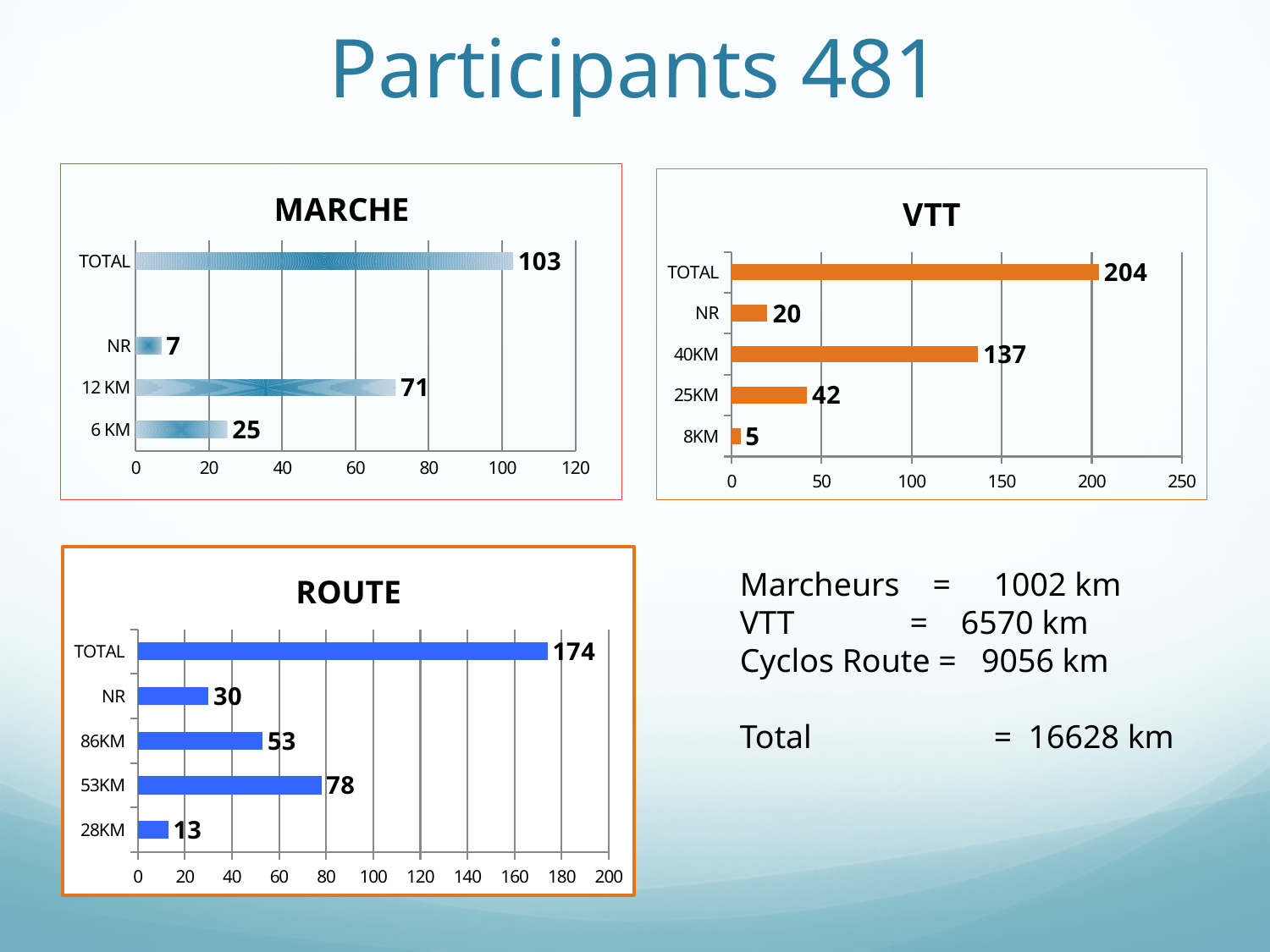
In the ROUTE chart, what is the value for 53KM? 78 In the ROUTE chart, how many categories are shown? 5 In the VTT chart, what is the value for 40KM? 137 What kind of chart is the VTT chart? bar chart What is the title of the chart at the bottom left of the slide? ROUTE In the MARCHE chart, how many categories are shown? 4 In the VTT chart, which category has the lowest value? 8KM In the VTT chart, what is the value for TOTAL? 204 In the MARCHE chart, what is the value for 12 KM? 71 In the VTT chart, what is the difference between the 40KM and 25KM values? 95 In the MARCHE chart, what is the value for 6 KM? 25 In the ROUTE chart, which is larger, the value for 86KM or the value for NR? 86KM